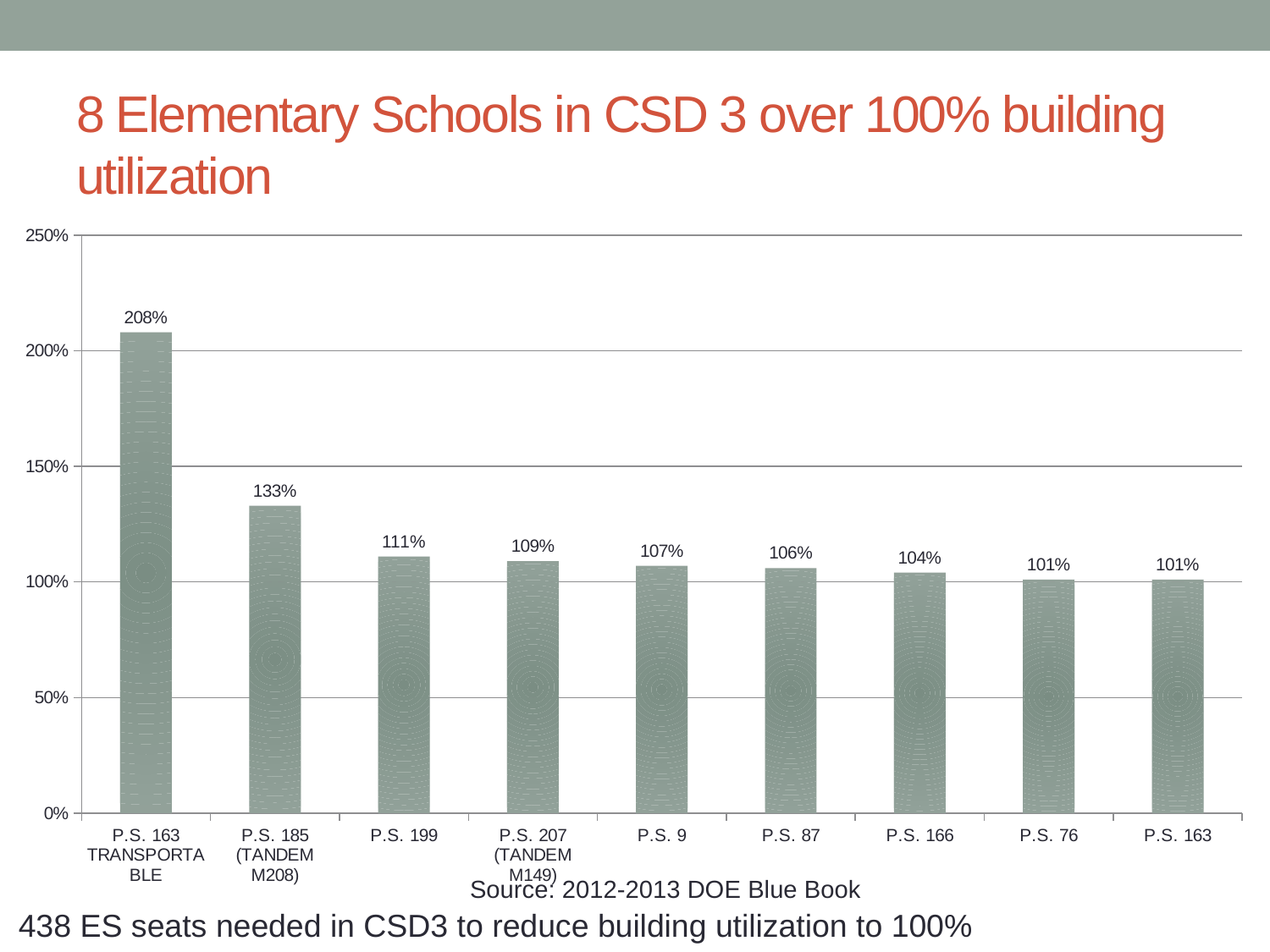
What is the difference between the values for P.S. 163 TRANSPORTABLE and P.S. 185 (TANDEM M208)? 75% Which is larger, the value for P.S. 207 (TANDEM M149) or the value for P.S. 76? P.S. 207 (TANDEM M149) What is the building utilization value for P.S. 163 TRANSPORTABLE? 208% Do the values rise or fall moving from left to right along the x axis? Fall What is the difference between the values for P.S. 199 and P.S. 9? 4% How many bars are plotted on the chart? 9 What is the lowest building utilization value shown on the chart? 101% What is the value shown for P.S. 166? 104% What is the building utilization value for P.S. 199? 111% What is the value shown for P.S. 87? 106% Which school has the highest building utilization? P.S. 163 TRANSPORTABLE What kind of chart is shown on the slide? Bar chart